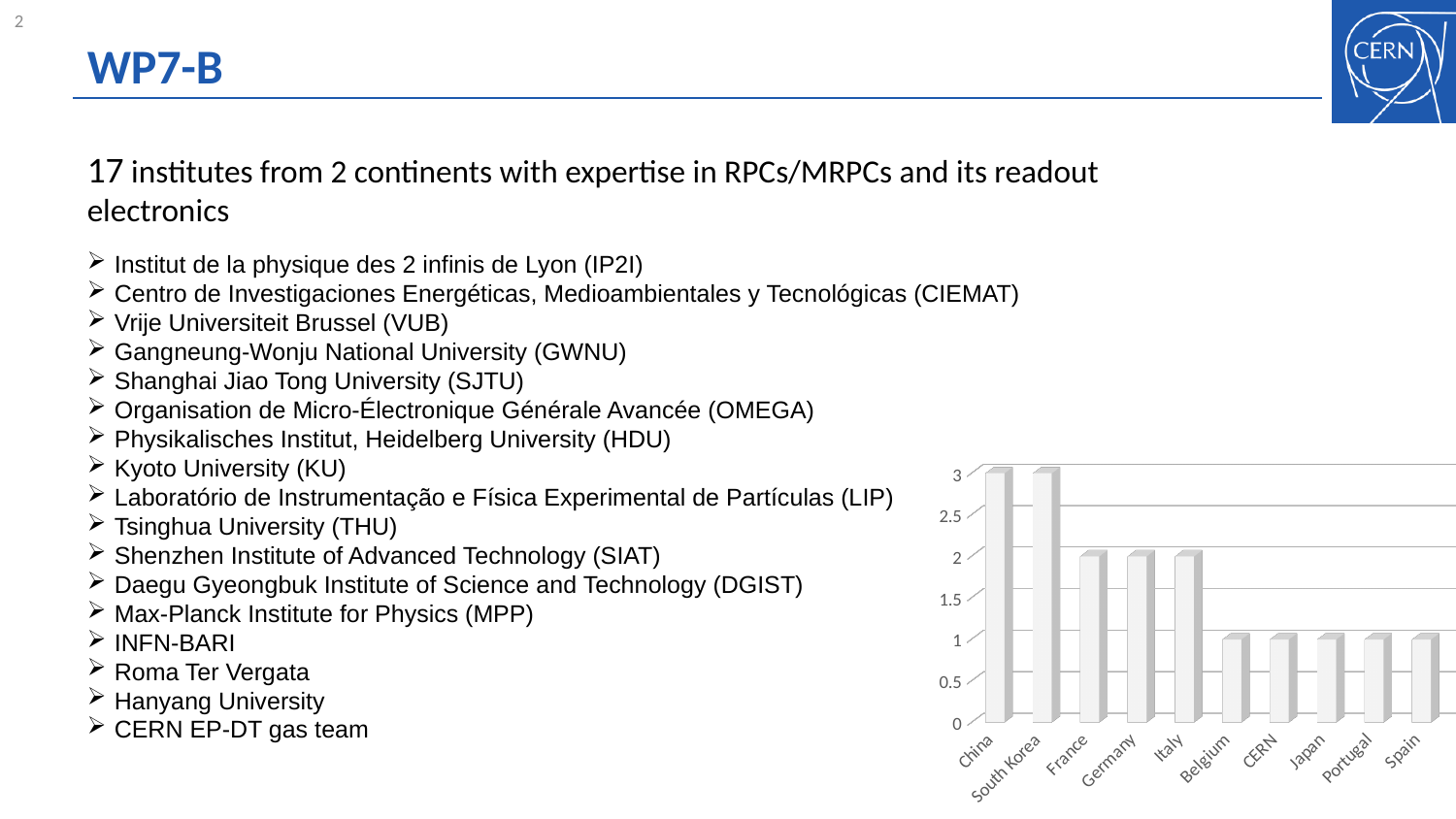
What kind of chart is shown on the slide? bar chart Which is larger in the chart, the value for Italy or the value for Japan? Italy What is the value for Germany in the chart? 2 Do the values in the chart generally rise or fall from left to right along the x axis? fall What is the value for China in the chart? 3 What is the difference between the value for China and the value for Belgium in the chart? 2 Which is larger in the chart, the value for China or the value for France? China What is the value for Belgium in the chart? 1 What is the value for Spain in the chart? 1 How many categories are shown on the x axis of the chart? 10 What is the value for South Korea in the chart? 3 Is the value for France in the chart greater or less than 1.5? greater